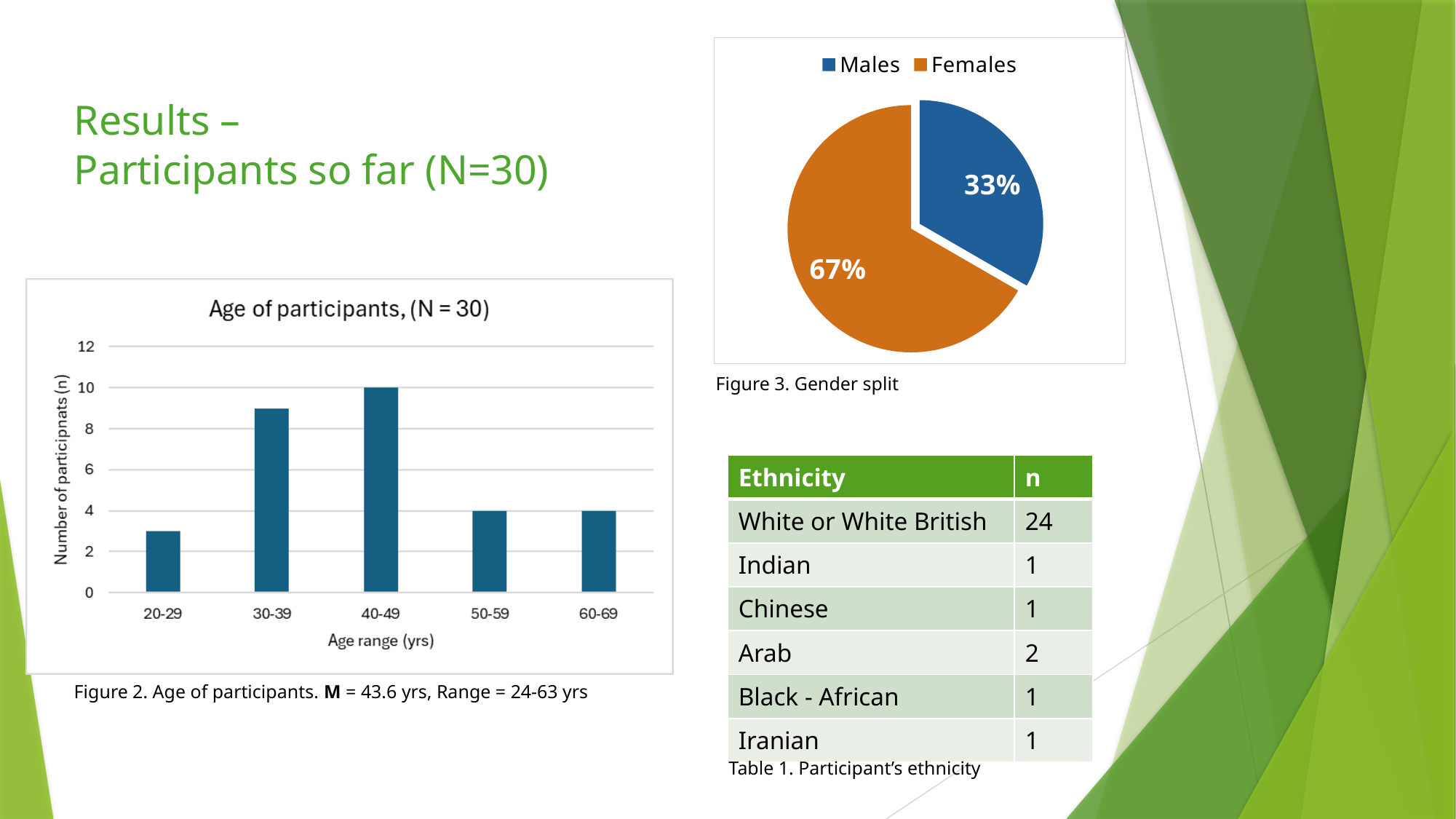
In the 'Age of participants, (N = 30)' chart, is the value for 30-39 greater or less than 8? greater In the 'Age of participants, (N = 30)' chart, what is the number of participants in the 50-59 age range? 4 In the 'Age of participants, (N = 30)' chart, what kind of chart is shown? bar chart In the 'Age of participants, (N = 30)' chart, which has more participants, the 30-39 or the 60-69 age range? 30-39 In the Figure 3 'Gender split' pie chart, how many categories does the legend list? 2 In the 'Age of participants, (N = 30)' chart, how many age ranges are shown on the x axis? 5 In the 'Age of participants, (N = 30)' chart, what is the number of participants in the 40-49 age range? 10 In the 'Age of participants, (N = 30)' chart, which age range has the lowest number of participants? 20-29 In the 'Age of participants, (N = 30)' chart, what is the label of the y axis? Number of participnats (n) In the 'Age of participants, (N = 30)' chart, is the value for 20-29 greater or less than 4? less In the 'Age of participants, (N = 30)' chart, which age range has the highest number of participants? 40-49 In the Figure 3 'Gender split' pie chart, what percentage of participants are Males? 33%